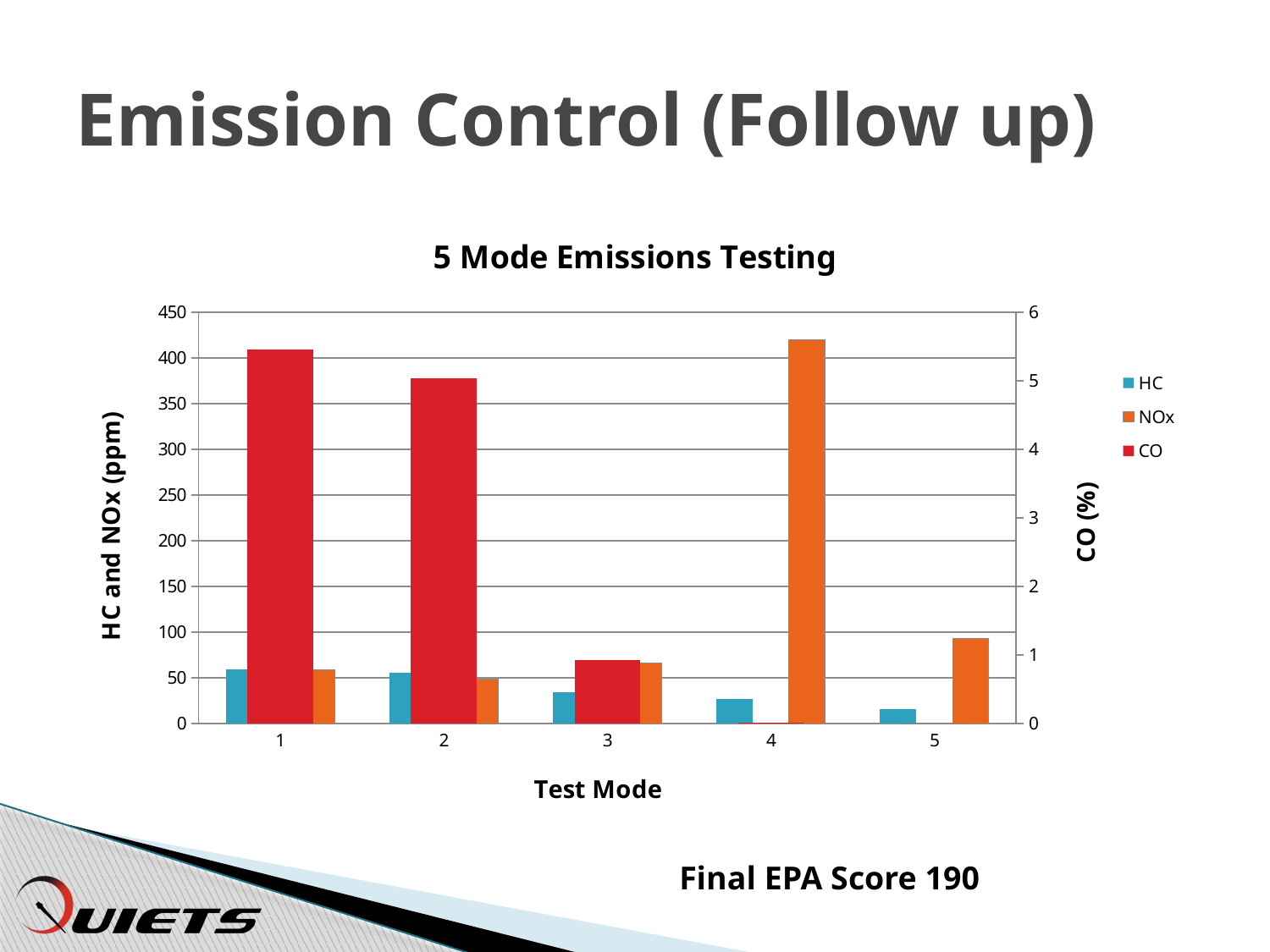
Which test mode has the highest NOx value? Test Mode 4 Is the HC value for Test Mode 1 greater or less than 100? less What kind of chart is shown on the slide? Bar chart How many series does the legend list? 3 Is the CO value for Test Mode 2 greater or less than 4 on the CO (%) axis? greater Which is larger, the CO value for Test Mode 1 or for Test Mode 2? Test Mode 1 What is the title of the chart? 5 Mode Emissions Testing How many test modes are shown on the x axis? 5 Do the HC values rise or fall from Test Mode 1 to Test Mode 5? Fall Which test mode has the highest CO value? Test Mode 1 Which test mode has the lowest HC value? Test Mode 5 Is the NOx value for Test Mode 4 greater or less than 400? greater